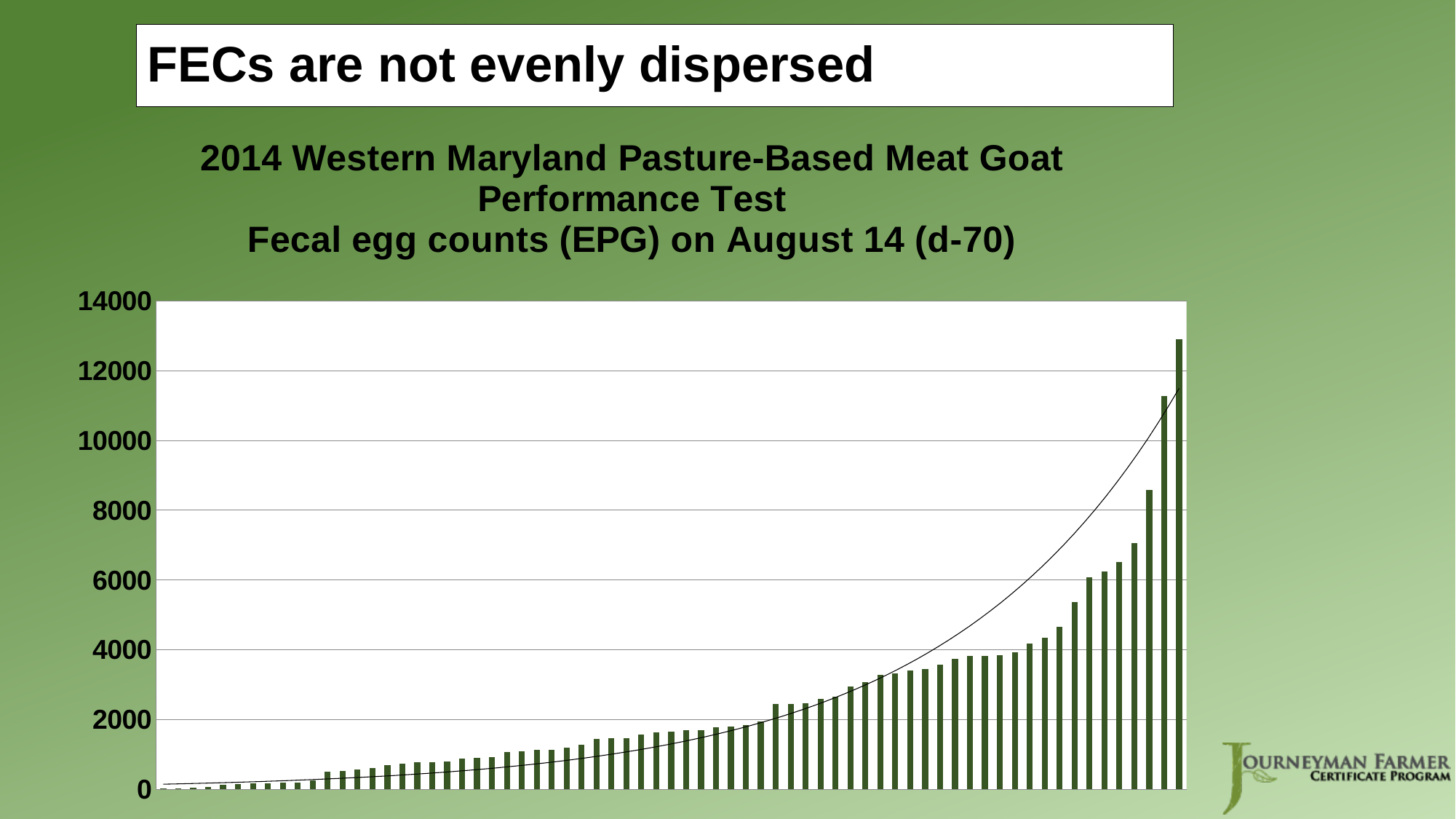
What is the highest value shown on the y axis? 14000 Is the value of the third tallest bar greater or less than 10000? less What date are the fecal egg counts in the chart title from? August 14 (d-70) Is the value of the tallest bar greater or less than 12000? greater Which bar is the tallest, the leftmost or the rightmost? rightmost Is the value of the tallest bar greater or less than 14000? less What kind of chart is shown on the slide? bar chart Do the bar values rise or fall from left to right along the x axis? rise